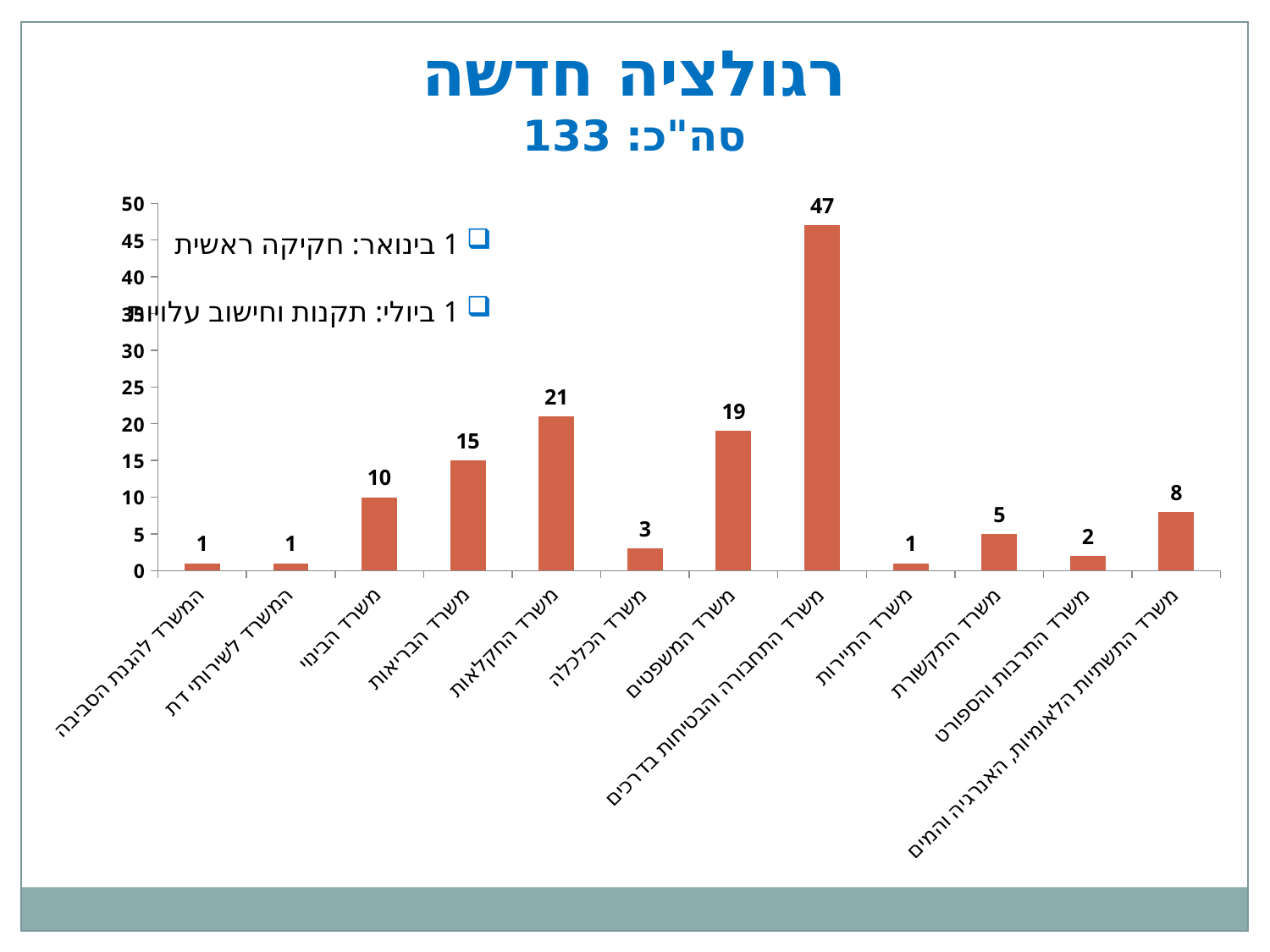
How many categories are shown on the x axis? 12 What kind of chart is shown on the slide? bar chart What is the value for משרד הבריאות? 15 What is the value for משרד התשתיות הלאומיות, האנרגיה והמים? 8 Is the value for משרד המשפטים greater or less than 25? less Which category has the highest value? משרד התחבורה והבטיחות בדרכים What is the difference between the values for משרד החקלאות and משרד המשפטים? 2 Which is larger, the value for משרד התקשורת or the value for משרד הכלכלה? משרד התקשורת What is the value for משרד התחבורה והבטיחות בדרכים? 47 What is the value for משרד החקלאות? 21 What total is stated in the slide subtitle? 133 What is the difference between the values for משרד התחבורה והבטיחות בדרכים and משרד הבינוי? 37